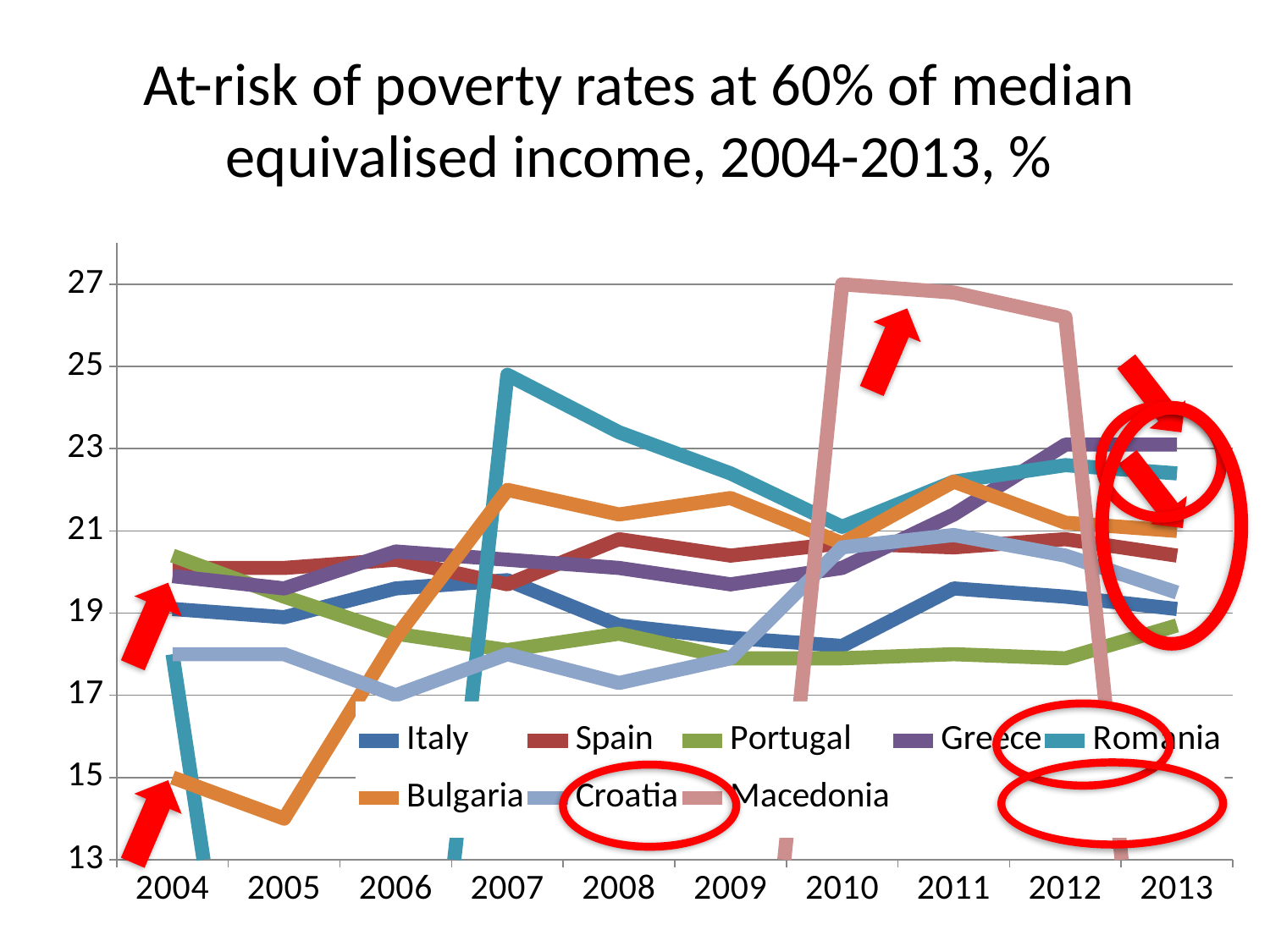
What kind of chart is shown on the slide? line chart How many series does the legend list? 8 Which country has the highest at-risk of poverty rate in 2010? Macedonia How many years are shown along the x axis? 10 Is the value for Bulgaria in 2005 greater or less than 15? less In 2007, which is higher: Romania or Bulgaria? Romania Is the value for Romania in 2007 greater or less than 23? greater Is the value for Macedonia in 2010 greater or less than 25? greater In 2013, which is higher: Greece or Italy? Greece Does the value for Portugal rise or fall from 2004 to 2009? fall What is the title of the chart? At-risk of poverty rates at 60% of median equivalised income, 2004-2013, %